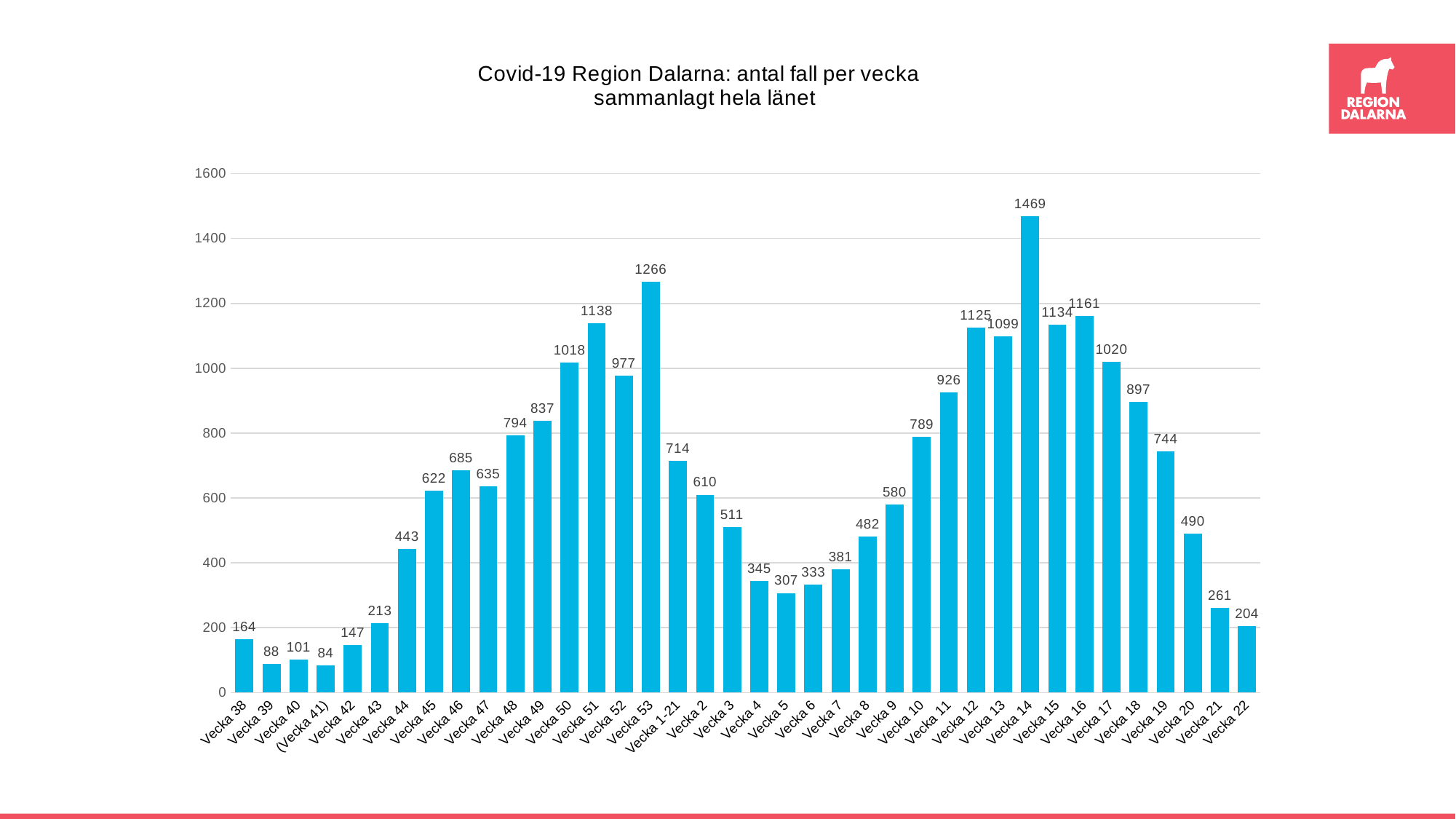
What is the value for Vecka 53? 1266 What is the value for Vecka 22? 204 What is the title of the chart? Covid-19 Region Dalarna: antal fall per vecka sammanlagt hela länet Which week has the lowest number of cases? (Vecka 41) What is the difference between the values for Vecka 16 and Vecka 15? 27 What is the difference between the values for Vecka 14 and Vecka 53? 203 Which is larger, the value for Vecka 51 or the value for Vecka 12? Vecka 51 Which week has the highest number of cases? Vecka 14 Is the value for Vecka 10 greater or less than 600? greater How many weeks (bars) are shown in the chart? 38 What is the value for Vecka 1-21? 714 What kind of chart is shown on the slide? bar chart